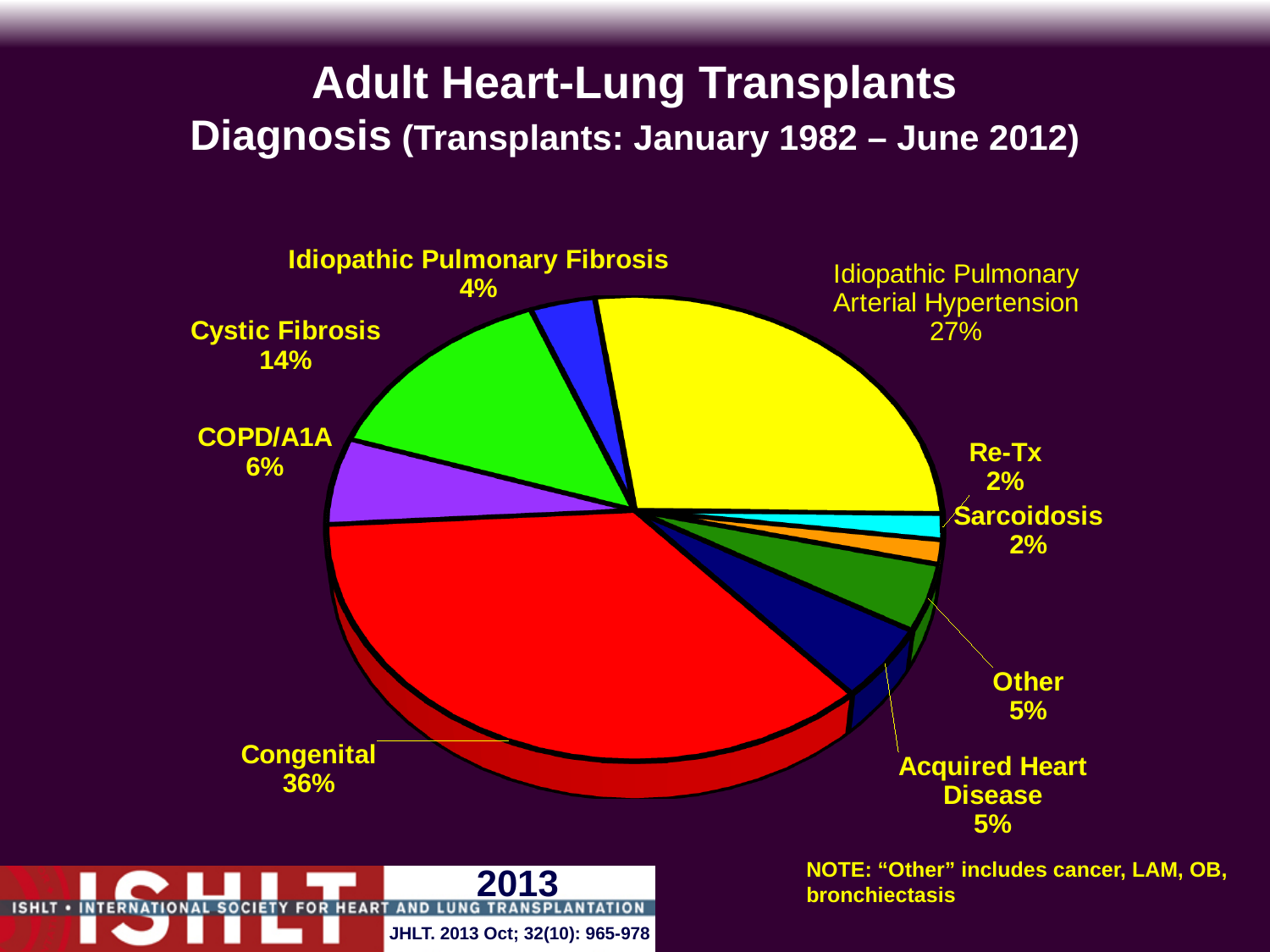
What percentage is shown for Idiopathic Pulmonary Fibrosis? 4% Which diagnosis accounts for the largest share of the pie? Congenital How many diagnosis categories are shown in the pie chart? 9 What share of the pie is Idiopathic Pulmonary Arterial Hypertension? 27% What percentage is shown for COPD/A1A? 6% What is the difference in percentage points between Congenital and Idiopathic Pulmonary Arterial Hypertension? 9 percentage points According to the note on the slide, what does the "Other" category include? Cancer, LAM, OB, bronchiectasis Which has a larger share, Cystic Fibrosis or COPD/A1A? Cystic Fibrosis What type of chart is shown on the slide? Pie chart What is the combined share of Other and Acquired Heart Disease? 10% What percentage of adult heart-lung transplants had a diagnosis of Congenital? 36% What percentage is shown for Cystic Fibrosis? 14%